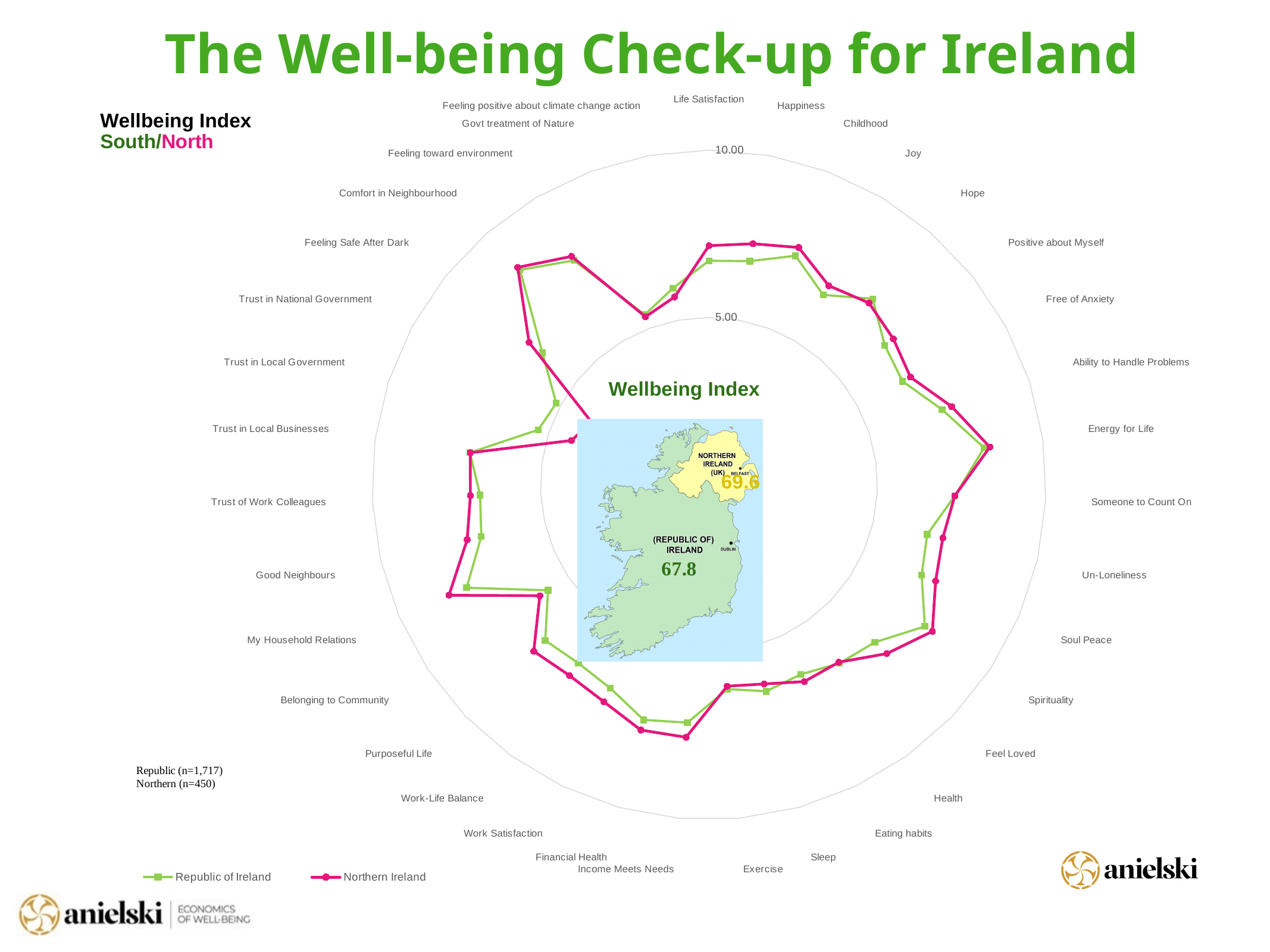
Which two series are listed in the chart legend? Republic of Ireland and Northern Ireland How many categories (axes) are plotted on the radar chart? 35 Is the Republic of Ireland value for Life Satisfaction greater or less than 10.00? less Is the Northern Ireland value for Good Neighbours greater or less than 5.00? greater Is the Republic of Ireland value for Energy for Life greater or less than 5.00? greater Which category has the highest value for Republic of Ireland? Comfort in Neighbourhood What Wellbeing Index value is printed for Northern Ireland on the map in the centre of the chart? 69.6 What kind of chart is shown on the slide? Radar chart Which category has the highest value for Northern Ireland? Comfort in Neighbourhood For Life Satisfaction, which series has the higher value, Republic of Ireland or Northern Ireland? Northern Ireland How many series does the legend list? 2 For Trust in Local Government, which series has the higher value, Republic of Ireland or Northern Ireland? Republic of Ireland